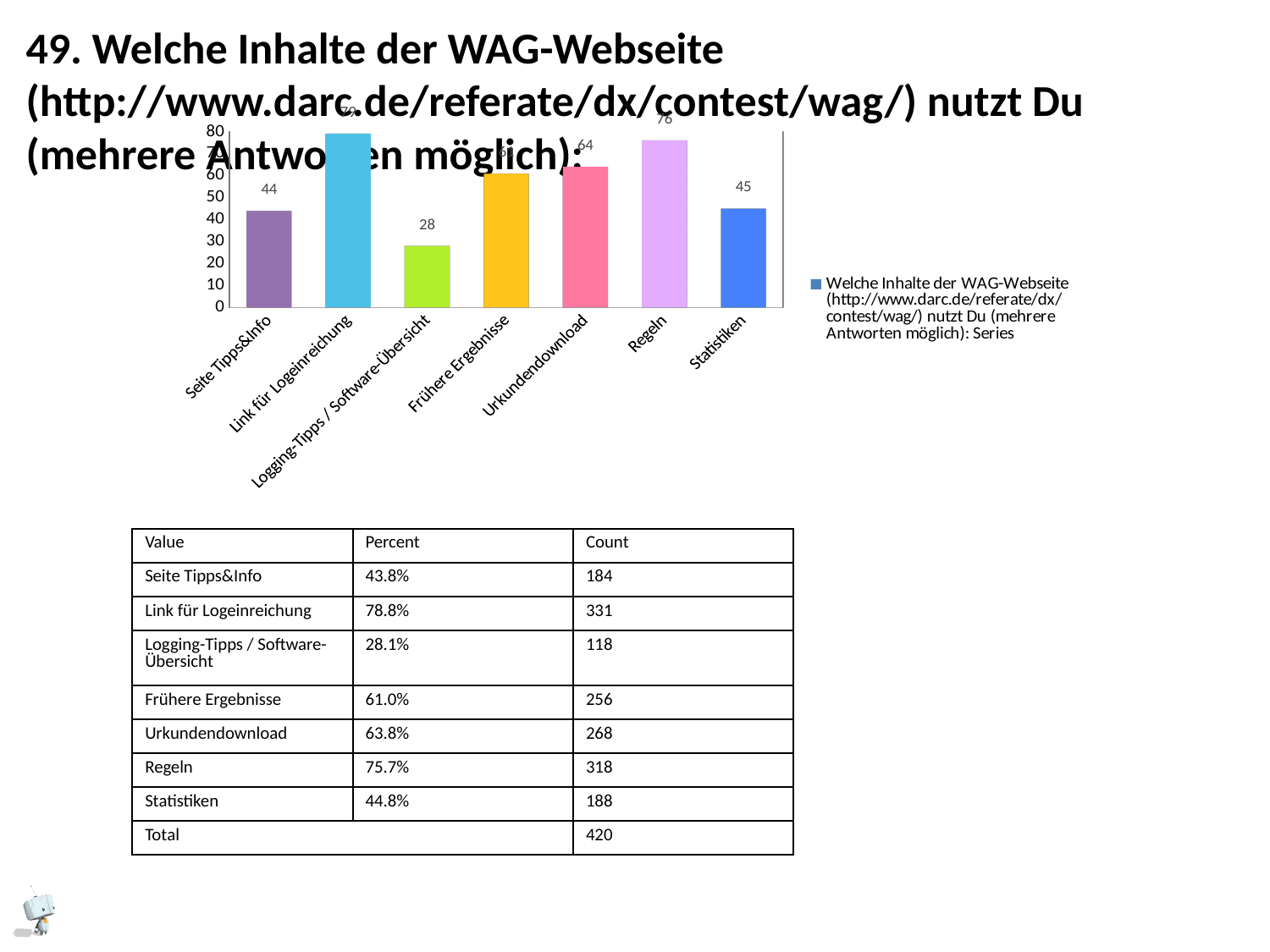
What is the value shown for Logging-Tipps / Software-Übersicht in the bar chart? 28 What is the value shown for Urkundendownload in the bar chart? 64 Which category has the highest bar in the bar chart? Link für Logeinreichung Is the value for Frühere Ergebnisse in the bar chart greater or less than 50? greater Which category has the lowest value in the bar chart? Logging-Tipps / Software-Übersicht Which has a larger value in the bar chart, Regeln or Statistiken? Regeln What is the value shown for Statistiken in the bar chart? 45 How many categories are plotted in the bar chart? 7 What is the difference between the values for Regeln and Urkundendownload in the bar chart? 12 What is the value shown for Regeln in the bar chart? 76 What type of chart is shown on the slide? bar chart What is the value shown for Seite Tipps&Info in the bar chart? 44